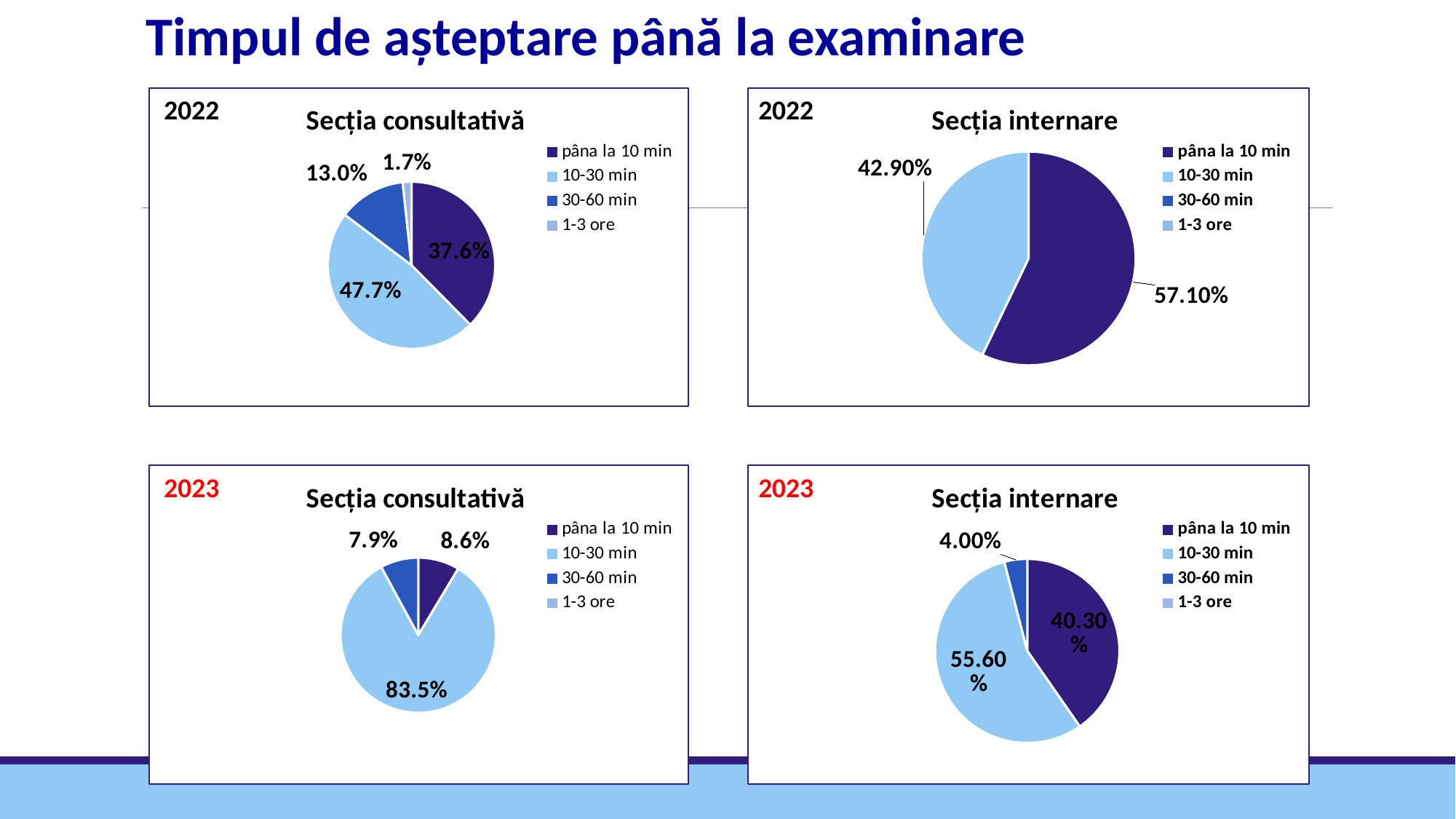
In the 2022 Secția consultativă pie chart, which category has the largest slice? 10-30 min What type of chart is used for the 2022 Secția internare data? Pie chart In the 2022 Secția internare pie chart, what is the difference between the pâna la 10 min slice and the 10-30 min slice? 14.20% In the 2022 Secția consultativă pie chart, what share is labelled for the 1-3 ore slice? 1.7% In the 2022 Secția internare pie chart, what share is labelled for the pâna la 10 min slice? 57.10% In the 2022 Secția consultativă pie chart, what share is labelled for the 10-30 min slice? 47.7% In the 2023 Secția consultativă pie chart, which is larger, the pâna la 10 min slice or the 30-60 min slice? pâna la 10 min In the 2023 Secția internare pie chart, what share is labelled for the 30-60 min slice? 4.00% How many entries does the legend of the 2023 Secția consultativă chart list? 4 In the 2023 Secția internare pie chart, what is the difference between the 10-30 min slice and the pâna la 10 min slice? 15.30% In the 2023 Secția internare pie chart, which category has the smallest labelled slice? 30-60 min In the 2023 Secția consultativă pie chart, what share is labelled for the 10-30 min slice? 83.5%